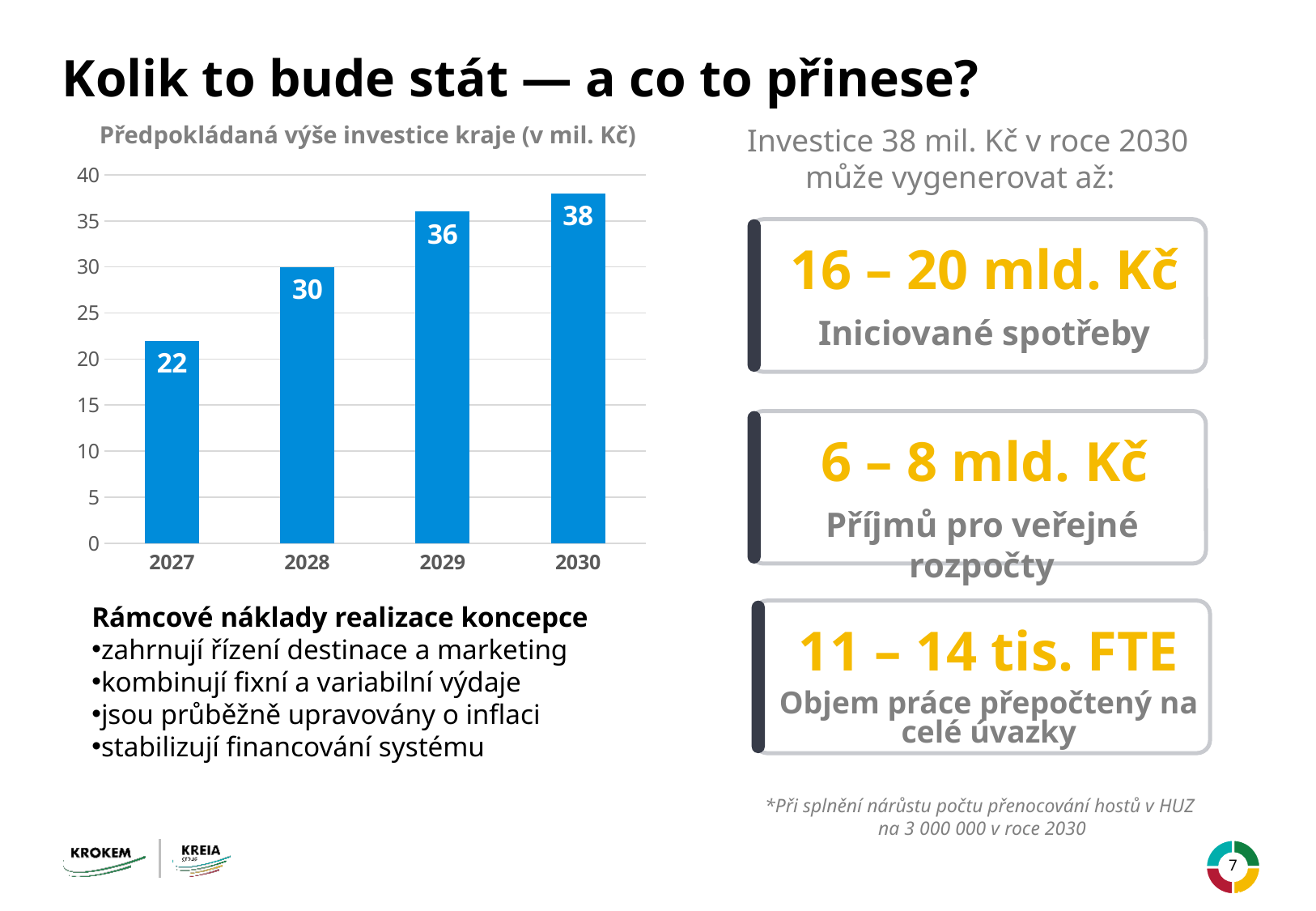
What is the expected investment value for 2029? 36 How many years are shown on the x axis of the chart? 4 Which year has the highest expected investment? 2030 Do the investment values rise or fall from 2027 to 2030? rise Is the value for 2028 greater or less than 25? greater What is the expected investment value for 2027? 22 Which year has the lowest expected investment? 2027 Which is larger, the investment for 2028 or for 2029? 2029 What is the title of the chart? Předpokládaná výše investice kraje (v mil. Kč) What kind of chart is shown on the slide? bar chart What is the difference between the investment values for 2030 and 2027? 16 What is the difference between the investment values for 2028 and 2027? 8